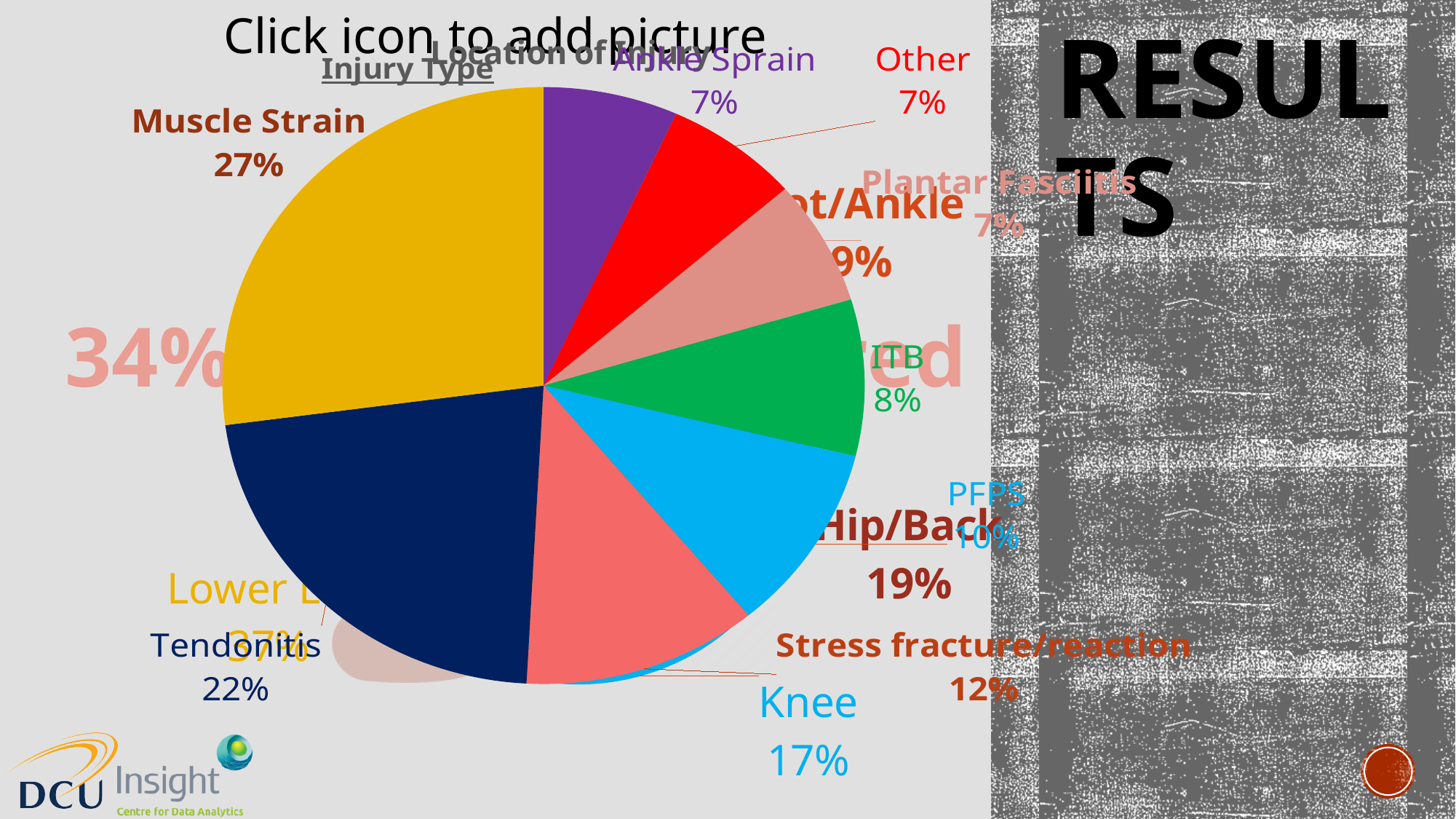
In the Injury Type pie chart, what colour is the Muscle Strain slice? yellow In the Injury Type pie chart, what percentage is Stress fracture/reaction? 12% In the Injury Type pie chart, which injury type has the largest share? Muscle Strain In the Injury Type pie chart, what percentage is ITB? 8% In the Injury Type pie chart, what percentage is Tendonitis? 22% In the Injury Type pie chart, which is larger, Tendonitis or Stress fracture/reaction? Tendonitis In the Injury Type pie chart, what percentage is Muscle Strain? 27% How many slices does the Injury Type pie chart have? 8 In the Injury Type pie chart, what percentage is PFPS? 10% In the Injury Type pie chart, what percentage is Ankle Sprain? 7% What kind of chart is the Injury Type chart? pie chart In the Injury Type pie chart, how many percentage points larger is Muscle Strain than Tendonitis? 5